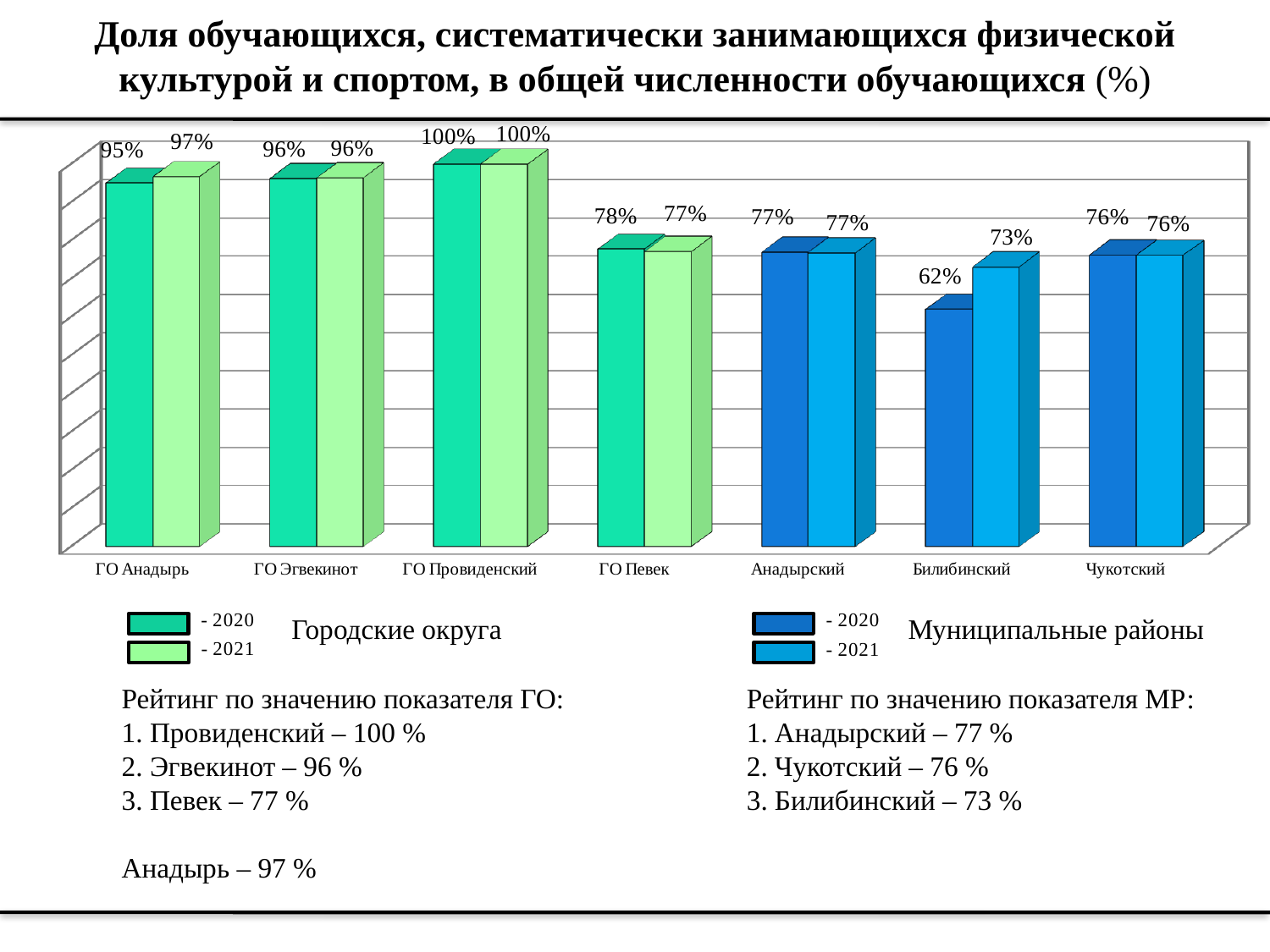
What is the 2020 value for Билибинский? 62% What is the 2020 value for Чукотский? 76% How many years of data does the chart compare for each category? 2 Which category has the highest value in 2021? ГО Провиденский What is the 2021 value for ГО Певек? 77% What is the difference between the 2021 and 2020 values for Билибинский? 11% Which is larger: the 2020 value for ГО Певек or the 2020 value for Анадырский? ГО Певек What is the 2021 value for ГО Анадырь? 97% How many categories are shown on the x axis? 7 Which category has the lowest value in 2020? Билибинский What kind of chart is shown on the slide? bar chart Which two years are listed in the chart legend? 2020 and 2021